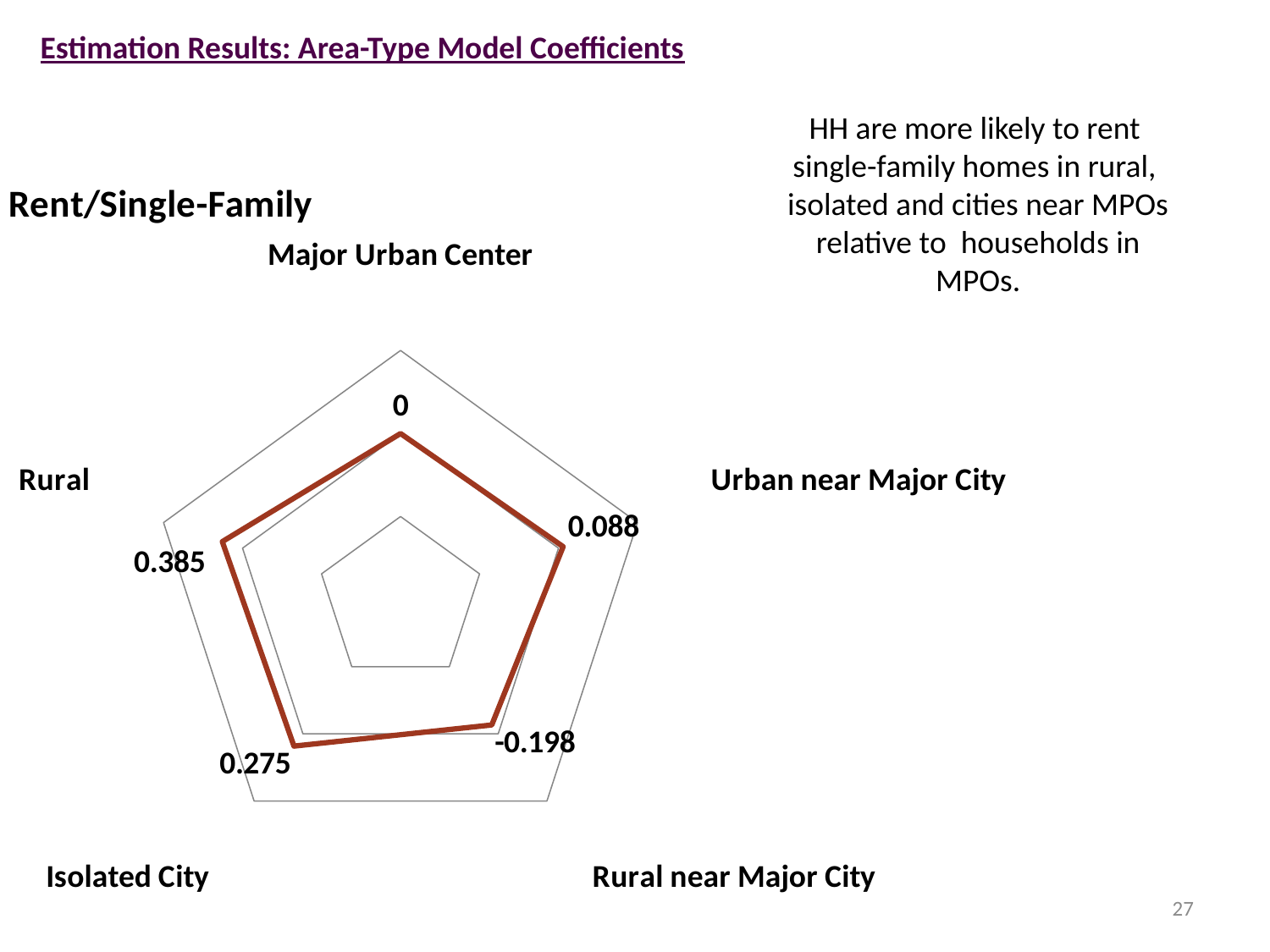
Which has a larger coefficient, Urban near Major City or Isolated City? Isolated City What is the coefficient value for Isolated City? 0.275 What is the difference between the coefficients for Rural and Isolated City? 0.110 What is the coefficient value for Rural in the Rent/Single-Family chart? 0.385 What is the coefficient value for Rural near Major City? -0.198 What kind of chart is shown on the slide? radar chart What is the coefficient value for Urban near Major City? 0.088 Which area type has the highest coefficient in the chart? Rural What is the title of the chart on the slide? Rent/Single-Family How many area-type categories are plotted on the radar chart? 5 Which area type has the lowest coefficient in the chart? Rural near Major City What is the coefficient value for Major Urban Center? 0